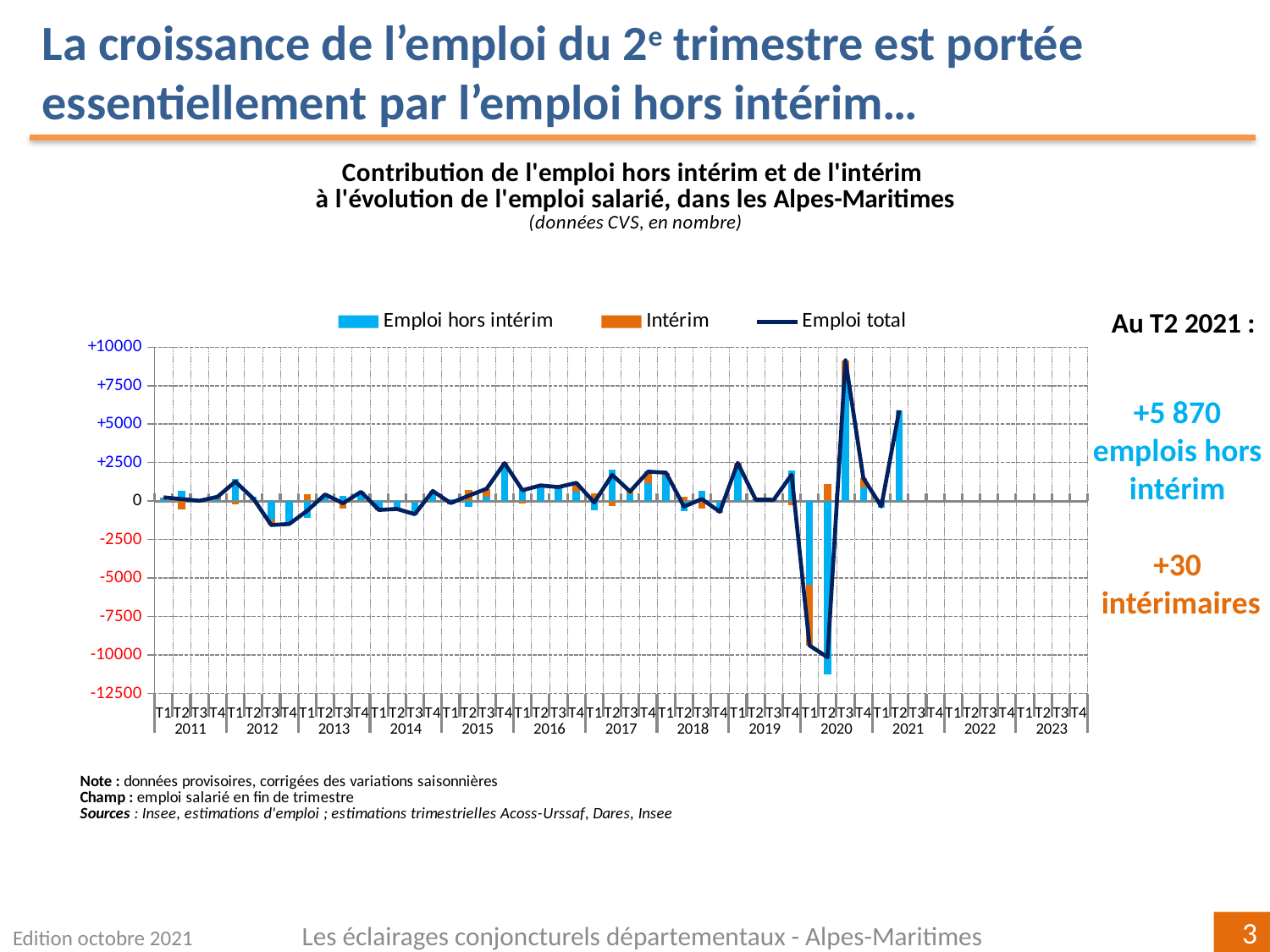
In which quarter is the 'Emploi hors intérim' bar the highest? T3 2020 Is the 'Emploi hors intérim' value for T2 2020 greater or less than -10000? less In which quarter is the 'Emploi hors intérim' bar the lowest? T2 2020 According to the slide, what is the contribution of 'emplois hors intérim' at T2 2021? +5 870 Which is larger, the 'Emploi hors intérim' bar for T3 2020 or for T2 2021? T3 2020 According to the slide, how many 'intérimaires' were added at T2 2021? +30 How many series does the chart legend list? 3 Is the 'Emploi total' value for T2 2021 greater or less than 5000? greater What kind of chart is shown on the slide? Combined bar and line chart What are the three series named in the chart legend? Emploi hors intérim, Intérim, Emploi total At T2 2021, how much larger is the 'emplois hors intérim' figure than the 'intérimaires' figure? 5 840